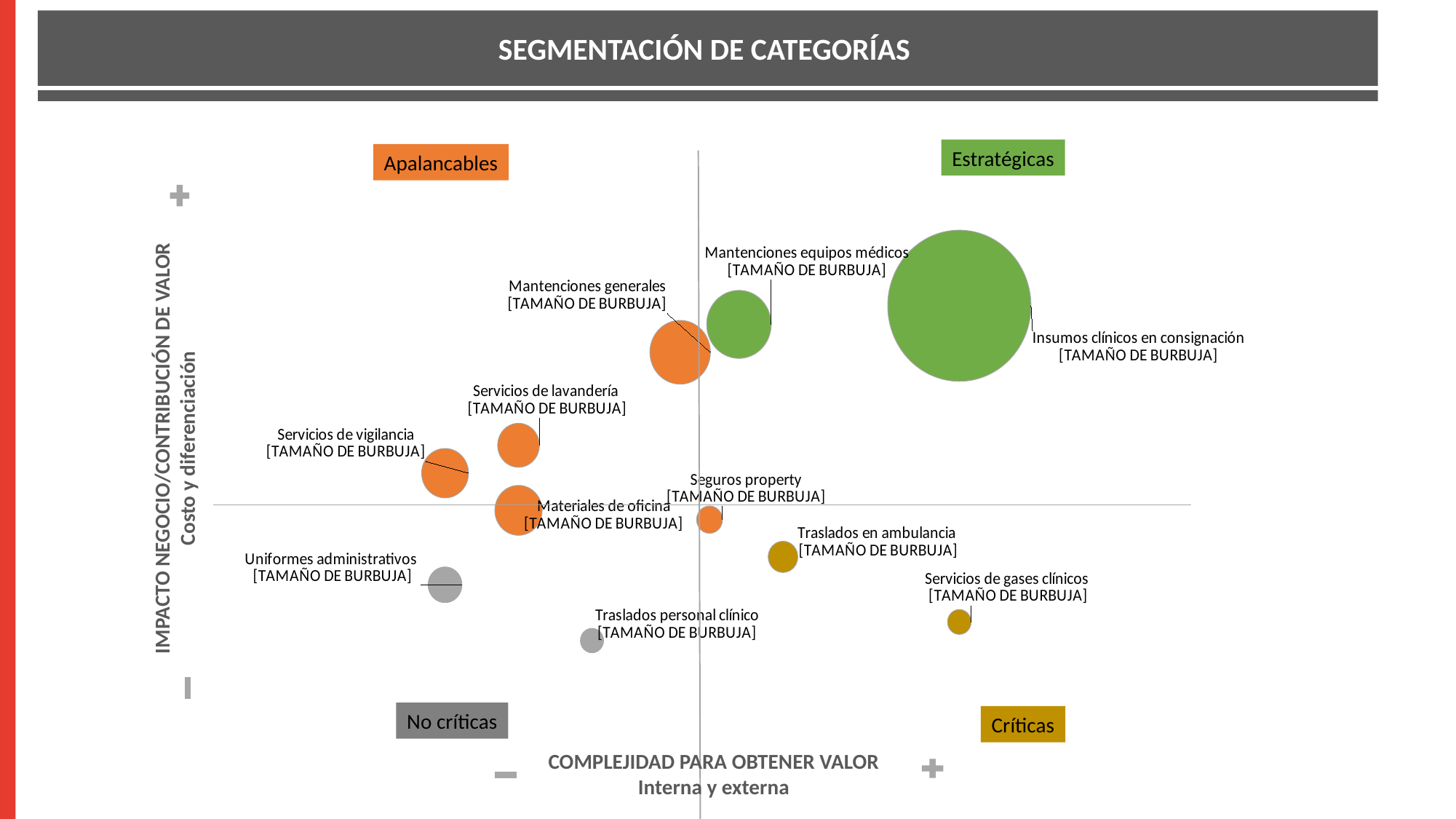
Which category has the smallest bubble on the chart? Servicios de gases clínicos What is the label of the horizontal axis? COMPLEJIDAD PARA OBTENER VALOR Interna y externa In which quadrant is the bubble for Uniformes administrativos located? No críticas How many bubbles (categories) are plotted on the chart? 11 Which category has the largest bubble on the chart? Insumos clínicos en consignación In which quadrant is the bubble for Traslados en ambulancia located? Críticas Which bubble is larger, Mantenciones generales or Seguros property? Mantenciones generales In which quadrant is the bubble for Servicios de vigilancia located? Apalancables What kind of chart is shown on the slide? Bubble chart In which quadrant is the bubble for Insumos clínicos en consignación located? Estratégicas Which bubble is larger, Servicios de lavandería or Traslados personal clínico? Servicios de lavandería What is the title of the chart? SEGMENTACIÓN DE CATEGORÍAS